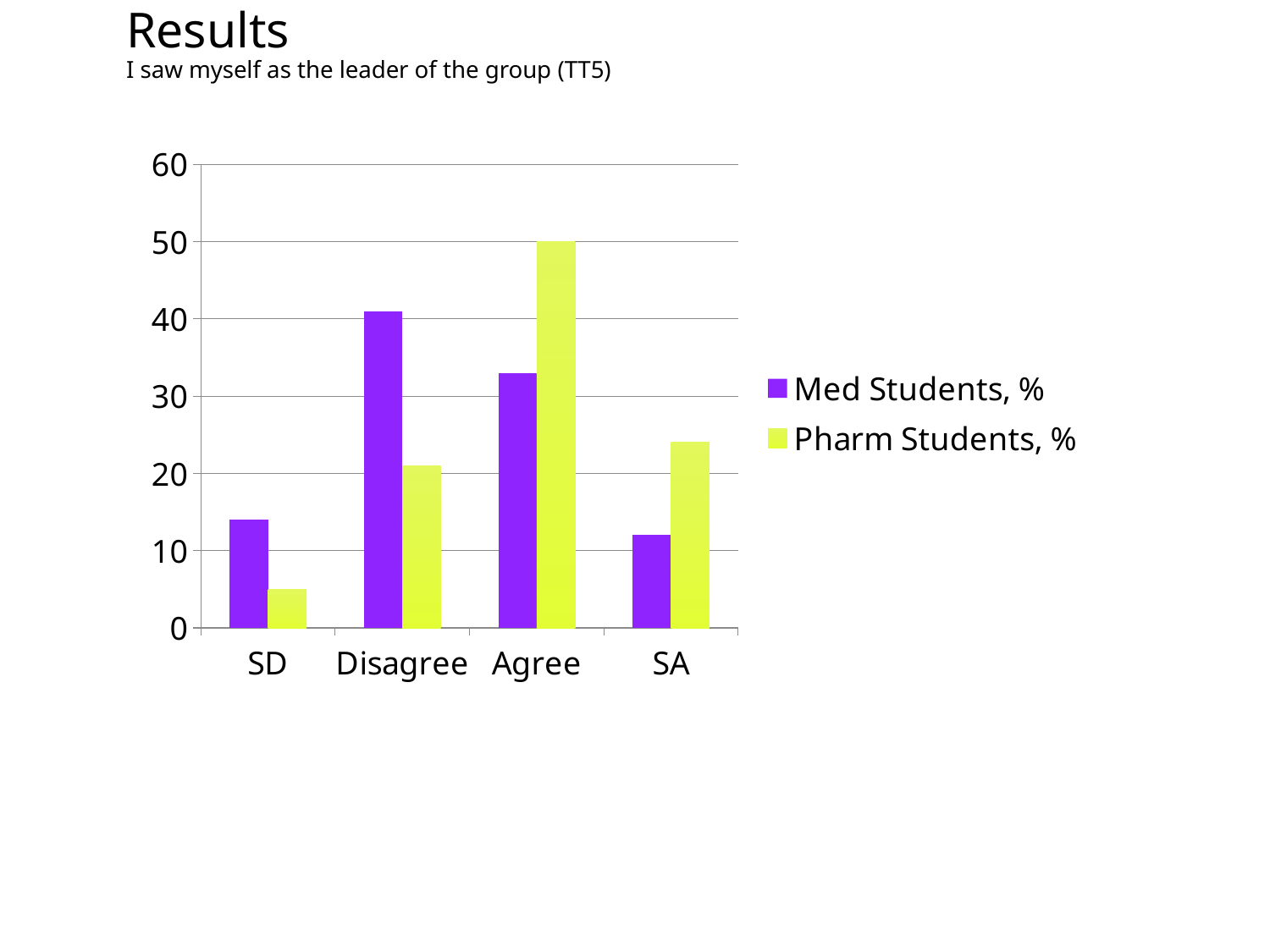
Which category has the highest value for Med Students, %? Disagree Which category has the lowest value for Pharm Students, %? SD For the Agree category, which series has the larger value, Med Students, % or Pharm Students, %? Pharm Students, % How many series does the legend list? 2 For the SA category, which series has the larger value, Med Students, % or Pharm Students, %? Pharm Students, % What colour are the bars for Med Students, %? purple How many categories are shown on the x axis? 4 What kind of chart is shown on the slide? bar chart Which category has the highest value for Pharm Students, %? Agree Is the value for Pharm Students, % in the SD category greater or less than 10? less For the Disagree category, which series has the larger value, Med Students, % or Pharm Students, %? Med Students, % Is the value for Med Students, % in the Disagree category greater or less than 30? greater